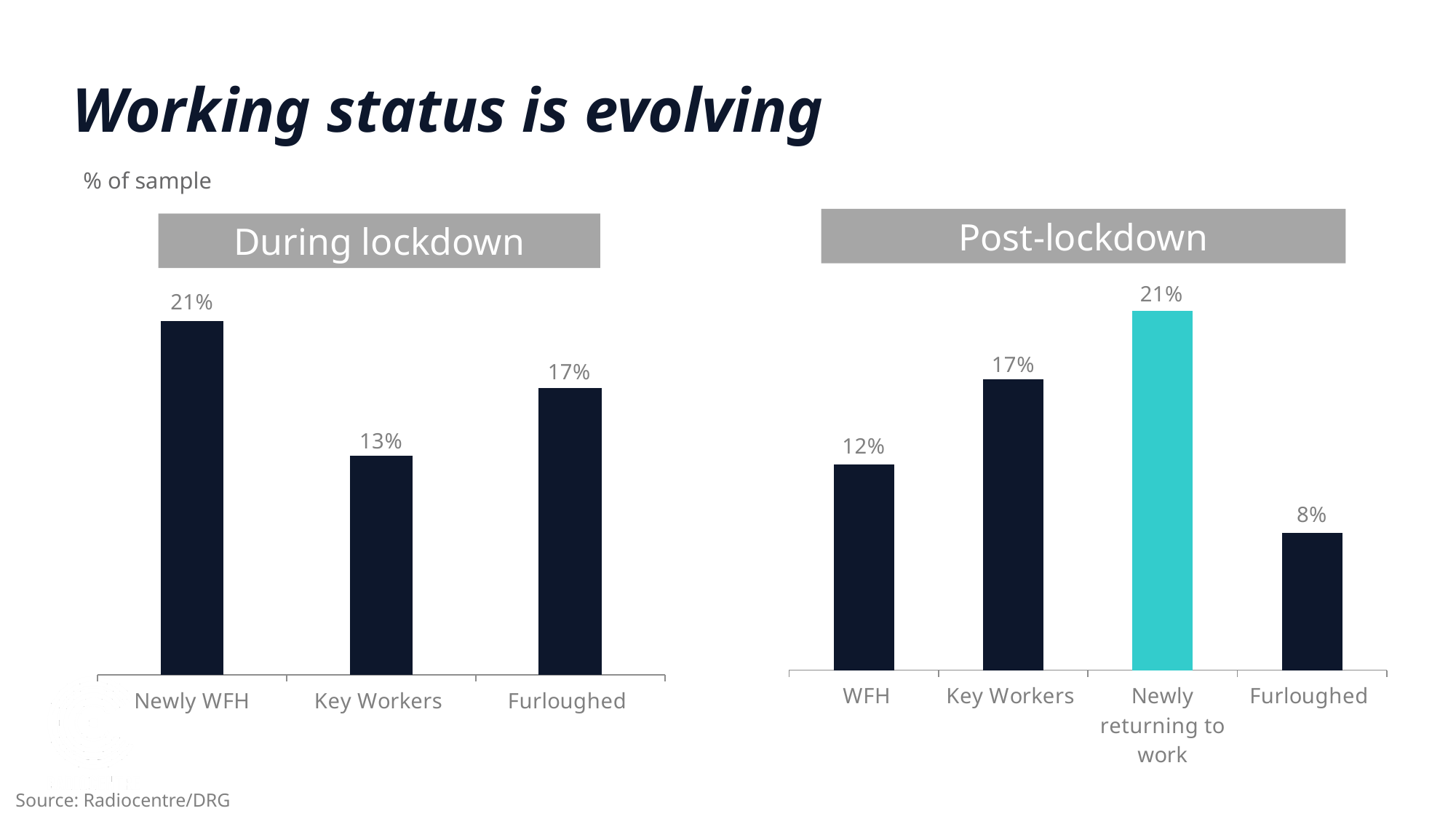
What kind of chart is the 'During lockdown' chart? Bar chart In the 'Post-lockdown' chart, what is the value for Furloughed? 8% How many categories are shown in the 'Post-lockdown' chart? 4 In the 'During lockdown' chart, which category has the lowest value? Key Workers In the 'During lockdown' chart, what is the difference between Newly WFH and Furloughed? 4% In the 'Post-lockdown' chart, which category has the lowest value? Furloughed In the 'During lockdown' chart, what is the value for Key Workers? 13% In the 'Post-lockdown' chart, what is the difference between Key Workers and WFH? 5% In the 'Post-lockdown' chart, which is larger, WFH or Key Workers? Key Workers In the 'Post-lockdown' chart, what is the value for Newly returning to work? 21% In the 'During lockdown' chart, what is the value for Newly WFH? 21% In the 'Post-lockdown' chart, which category has the highest value? Newly returning to work